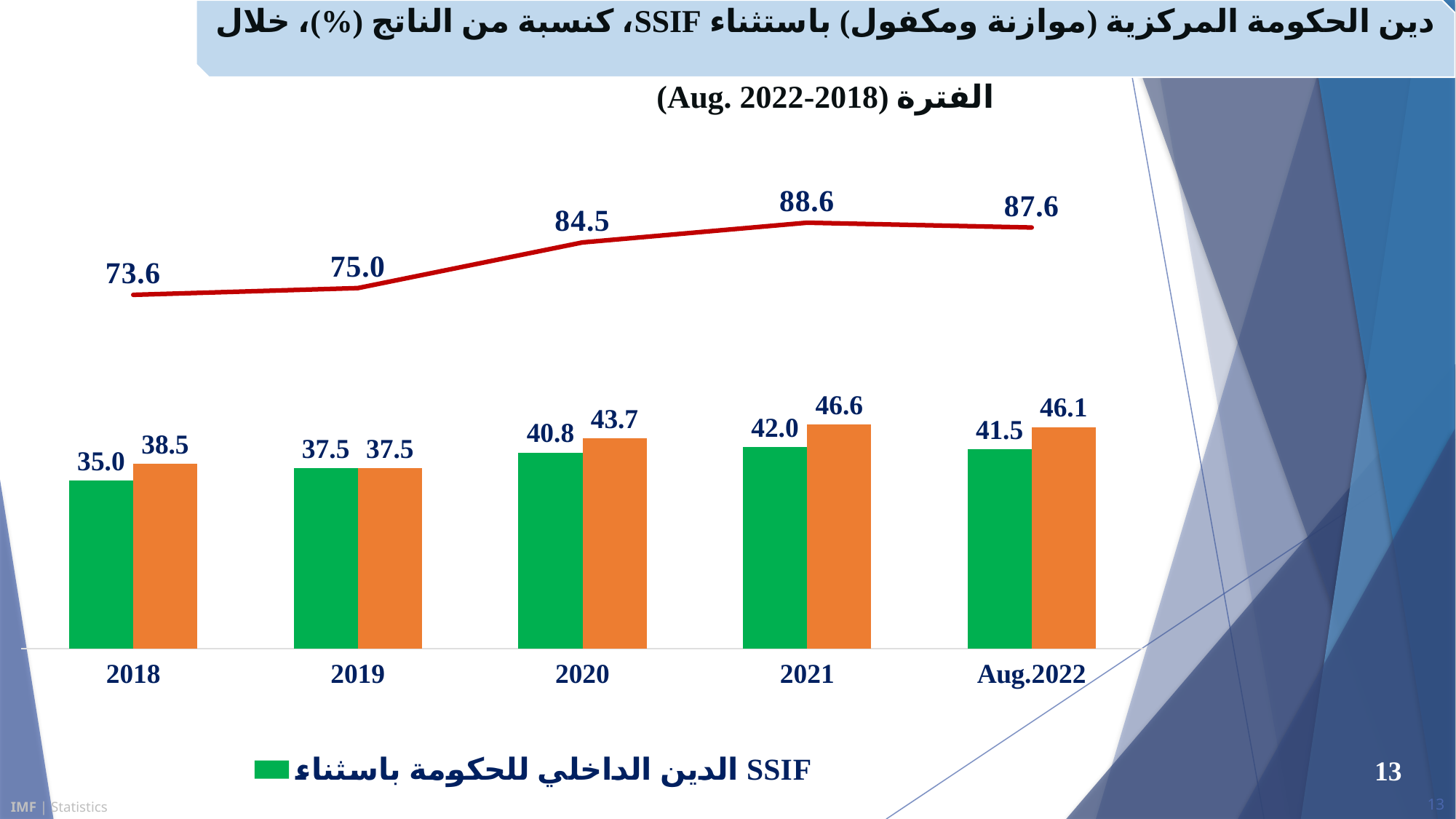
Which is larger for 2018: the green bar or the orange bar? the orange bar What is the value of the green bar for Aug.2022? 41.5 What is the difference between the red line values for 2021 and Aug.2022? 1.0 Which year has the lowest green bar value? 2018 What is the value of the green bar (الدين الداخلي للحكومة باستثناء SSIF) for 2018? 35.0 Does the red line rise or fall from 2018 to 2021? rise What is the difference between the orange bar and the green bar for 2020? 2.9 In which year does the red line reach its highest value? 2021 What is the value of the orange bar for 2021? 46.6 What colour is the series labelled 'الدين الداخلي للحكومة باستثناء SSIF' in the legend? green What is the value of the red line for 2020? 84.5 How many periods are shown on the x axis? 5